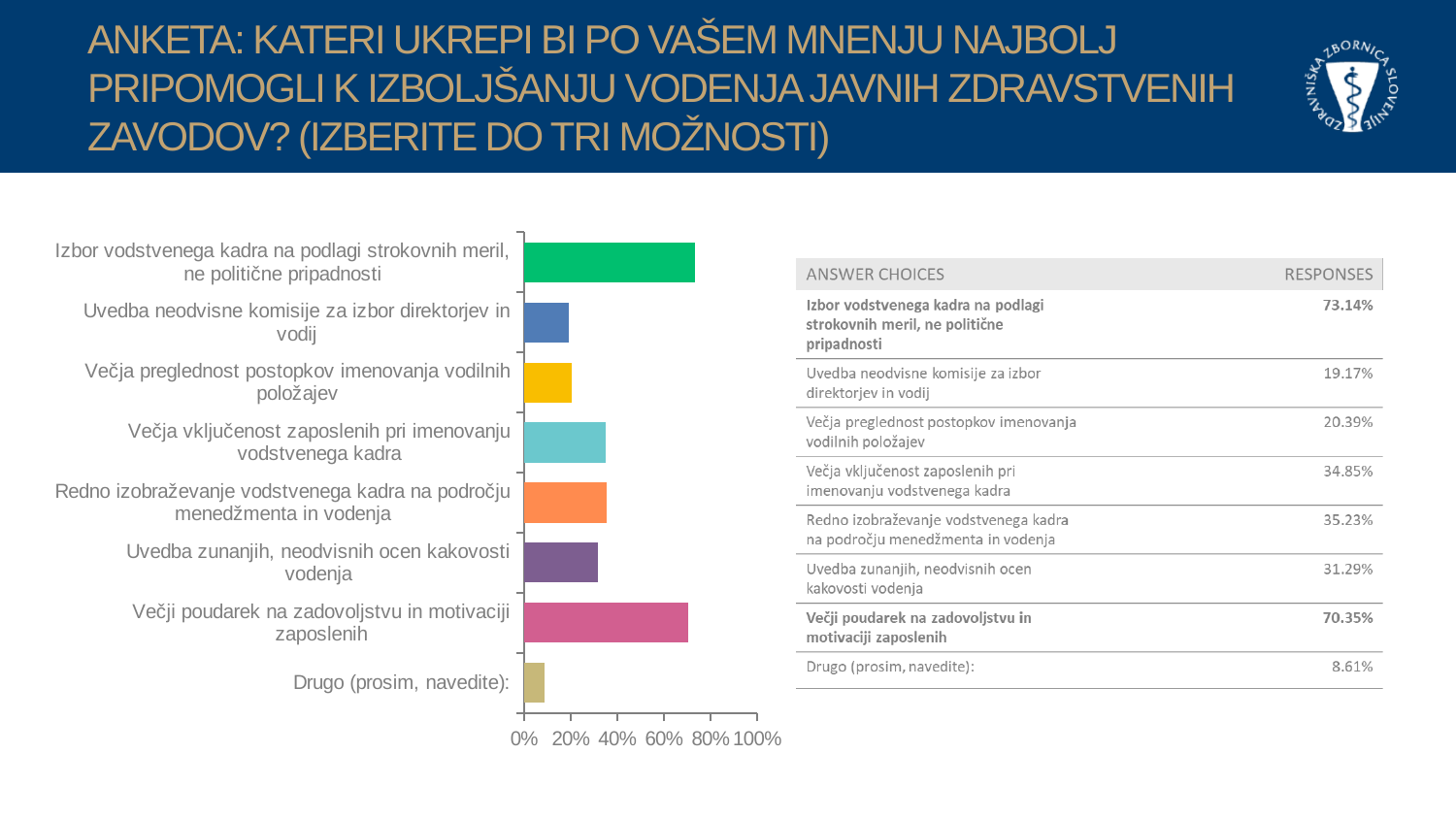
What is the difference in percentage points between "Izbor vodstvenega kadra na podlagi strokovnih meril, ne politične pripadnosti" (73.14%) and "Večji poudarek na zadovoljstvu in motivaciji zaposlenih" (70.35%)? 2.79 What is the maximum value shown on the horizontal axis of the bar chart? 100% Which has a larger response share: "Uvedba zunanjih, neodvisnih ocen kakovosti vodenja" or "Uvedba neodvisne komisije za izbor direktorjev in vodij"? Uvedba zunanjih, neodvisnih ocen kakovosti vodenja What kind of chart is shown on the slide? bar chart Is the value for "Drugo (prosim, navedite):" greater or less than 20%? less Which answer choice has the highest response share? Izbor vodstvenega kadra na podlagi strokovnih meril, ne politične pripadnosti What is the response share for "Večji poudarek na zadovoljstvu in motivaciji zaposlenih"? 70.35% What is the response share for "Uvedba zunanjih, neodvisnih ocen kakovosti vodenja"? 31.29% How many answer choices (categories) are plotted in the bar chart? 8 Which answer choice has the lowest response share? Drugo (prosim, navedite): What is the response share for "Drugo (prosim, navedite):"? 8.61% What is the response share for "Uvedba neodvisne komisije za izbor direktorjev in vodij"? 19.17%